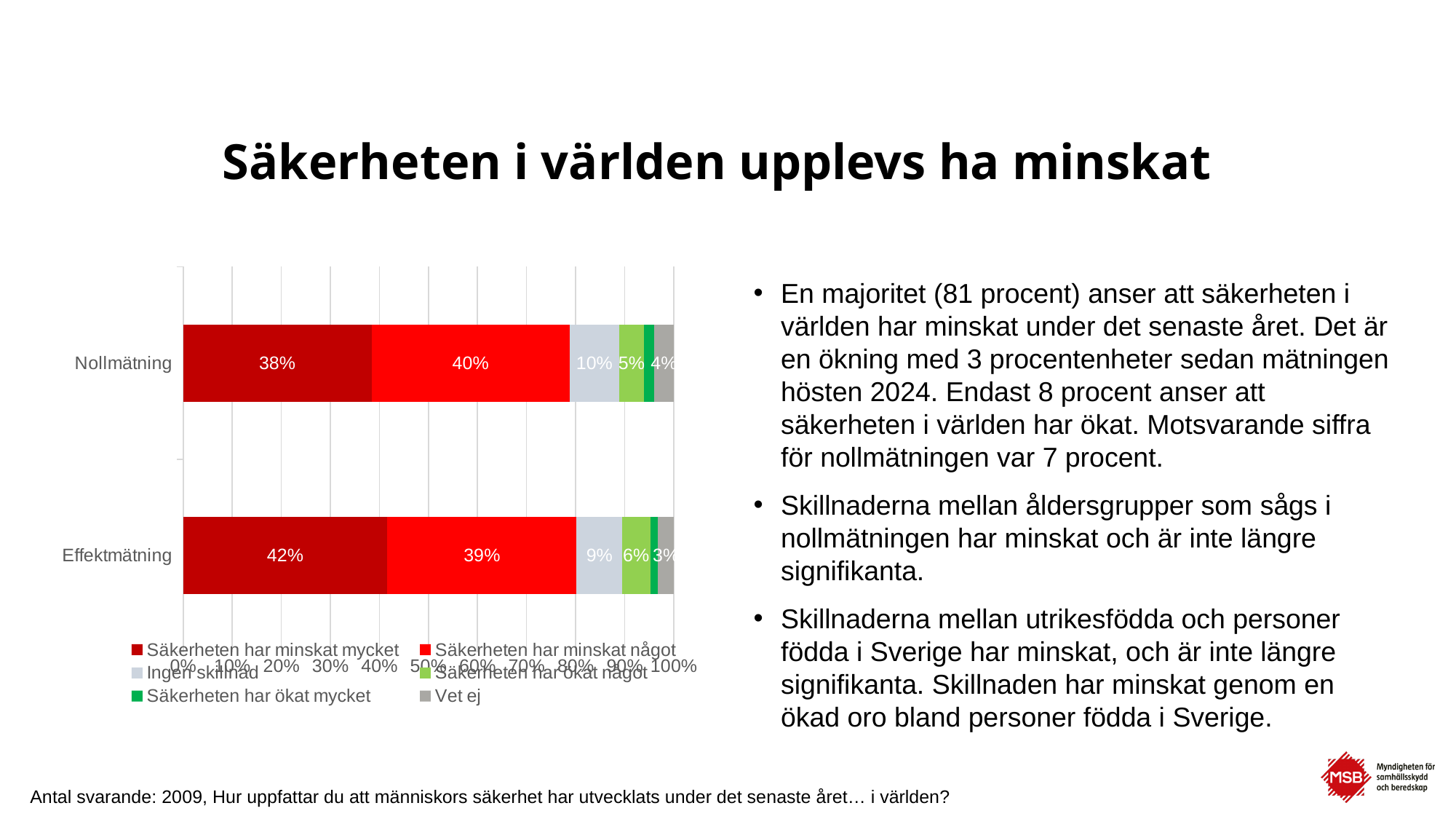
What type of chart is shown on the slide? Stacked bar chart What percentage of respondents in the Effektmätning bar answered "Säkerheten har minskat mycket"? 42% What percentage of respondents in the Nollmätning bar answered "Säkerheten har minskat mycket"? 38% Which legend entry is shown in dark red? Säkerheten har minskat mycket Which bar has the larger "Säkerheten har minskat något" segment, Nollmätning or Effektmätning? Nollmätning How many series does the chart legend list? 6 What is the value of the "Ingen skillnad" segment for Effektmätning? 9% How many categories (bars) are shown in the chart? 2 What is the value of the "Vet ej" segment for Nollmätning? 4% What is the value of the "Säkerheten har ökat något" segment for Effektmätning? 6% By how many percentage points does the "Säkerheten har minskat mycket" share for Effektmätning exceed that for Nollmätning? 4 percentage points What is the value of the "Säkerheten har minskat något" segment for Nollmätning? 40%